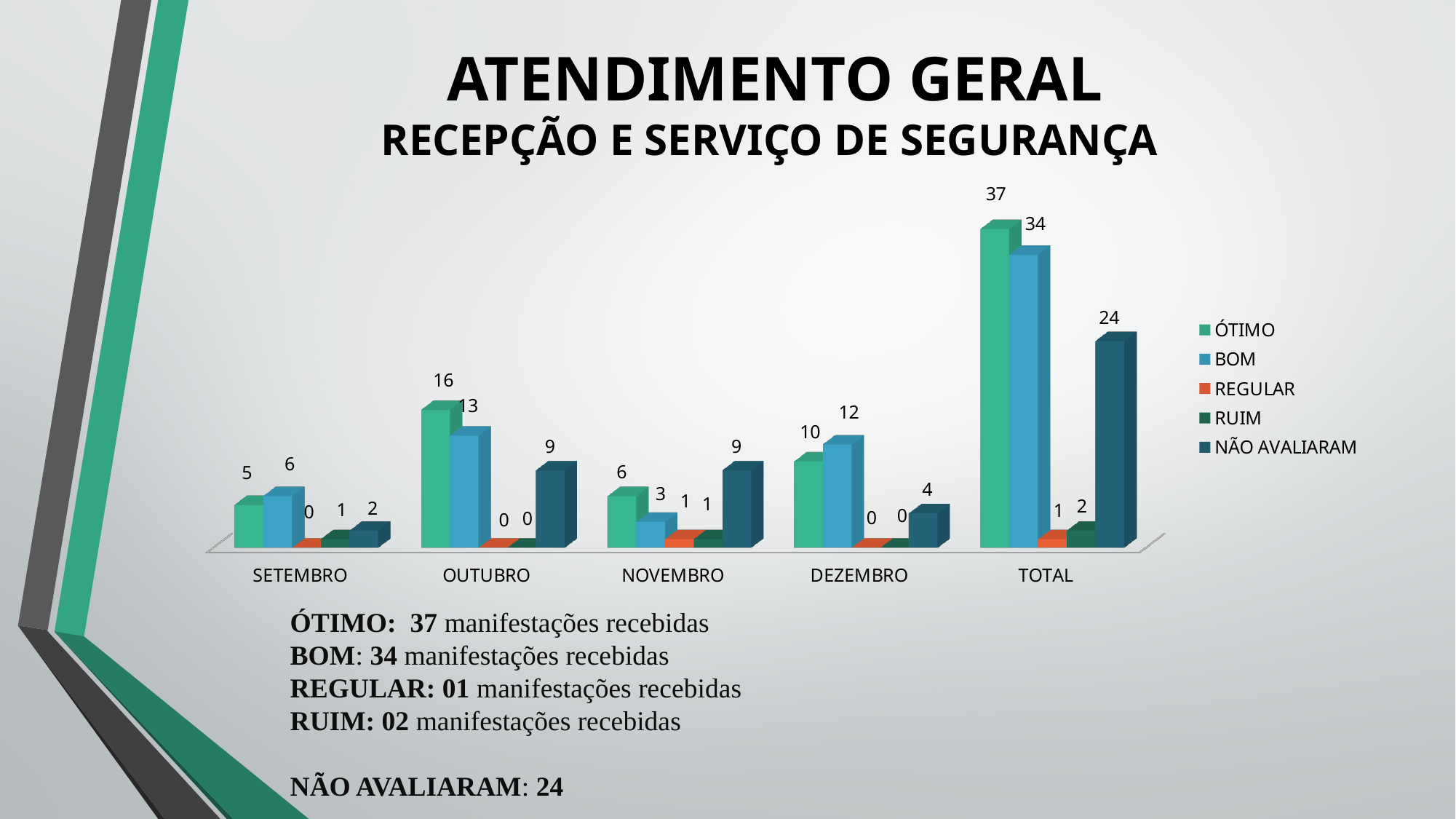
Which month (excluding TOTAL) has the highest value for ÓTIMO? OUTUBRO What is the value for RUIM in SETEMBRO? 1 What is the value for BOM in OUTUBRO? 13 What is the value for NÃO AVALIARAM in NOVEMBRO? 9 How many categories are shown on the x axis? 5 Which series is shown in orange in the legend? REGULAR Which is larger in DEZEMBRO, ÓTIMO or BOM? BOM What is the difference between the ÓTIMO and BOM values in TOTAL? 3 What kind of chart is shown on the slide? Bar chart How many series does the legend list? 5 What is the value for ÓTIMO in TOTAL? 37 Which month (excluding TOTAL) has the lowest value for BOM? NOVEMBRO